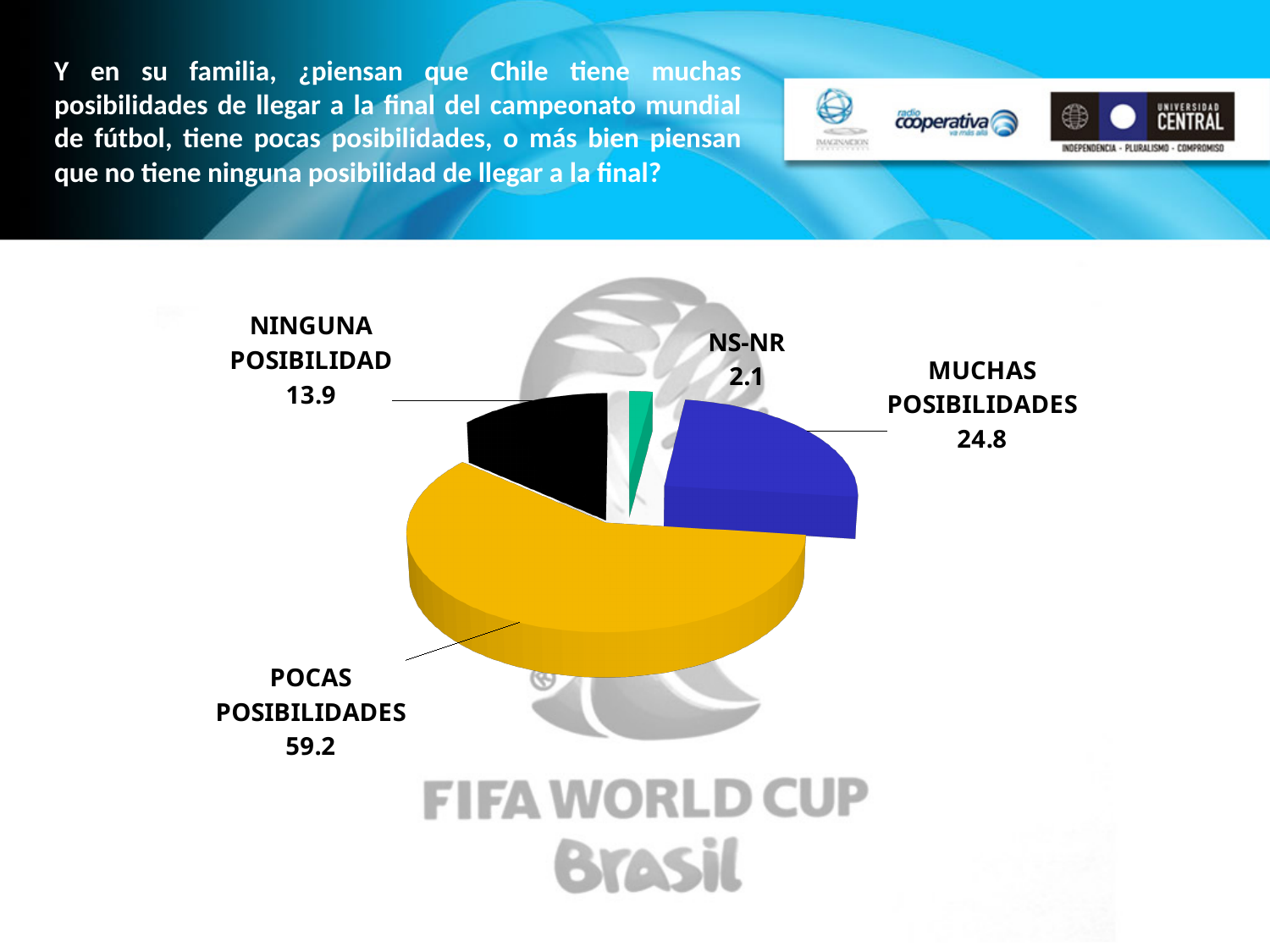
What kind of chart is shown on the slide? pie chart What is the value for NINGUNA POSIBILIDAD? 13.9 Which category has the smallest slice of the pie? NS-NR What is the value for NS-NR? 2.1 What is the difference between the values for MUCHAS POSIBILIDADES and NINGUNA POSIBILIDAD? 10.9 How many slices does the pie chart have? 4 What is the difference between the values for POCAS POSIBILIDADES and MUCHAS POSIBILIDADES? 34.4 What is the value for POCAS POSIBILIDADES? 59.2 Which category has the largest slice of the pie? POCAS POSIBILIDADES What is the value for MUCHAS POSIBILIDADES? 24.8 What colour is the POCAS POSIBILIDADES slice? yellow Which is larger, the value for MUCHAS POSIBILIDADES or the value for NINGUNA POSIBILIDAD? MUCHAS POSIBILIDADES